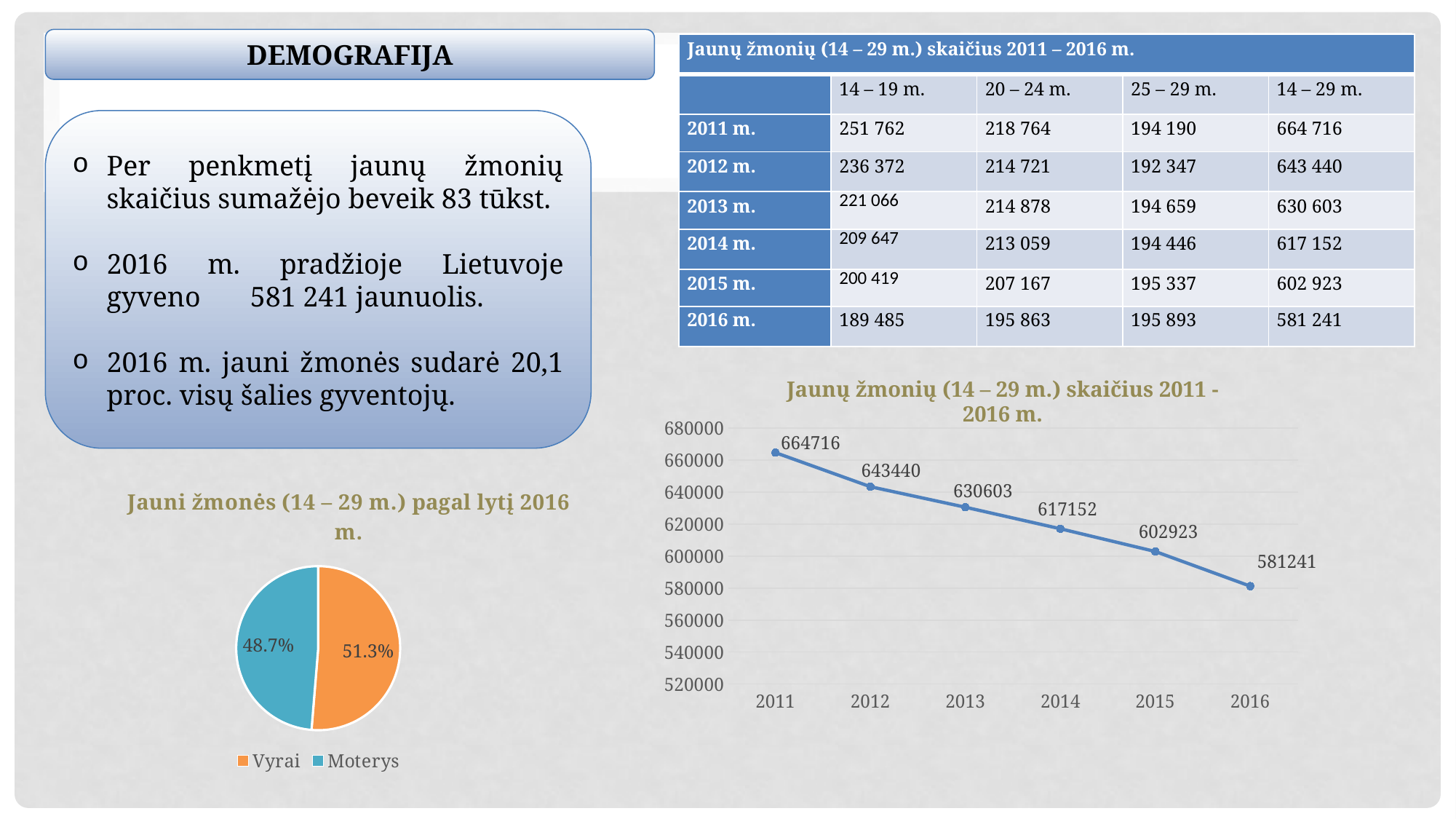
What kind of chart is 'Jaunų žmonių (14 – 29 m.) skaičius 2011 - 2016 m.'? line chart In the line chart 'Jaunų žmonių (14 – 29 m.) skaičius 2011 - 2016 m.', which year has the lowest value? 2016 In the pie chart 'Jauni žmonės (14 – 29 m.) pagal lytį 2016 m.', what share is Vyrai? 51.3% In the line chart 'Jaunų žmonių (14 – 29 m.) skaičius 2011 - 2016 m.', what is the value for 2011? 664716 In the line chart 'Jaunų žmonių (14 – 29 m.) skaičius 2011 - 2016 m.', how many years are plotted? 6 In the line chart 'Jaunų žmonių (14 – 29 m.) skaičius 2011 - 2016 m.', which year has the highest value? 2011 In the pie chart 'Jauni žmonės (14 – 29 m.) pagal lytį 2016 m.', how many entries does the legend list? 2 In the line chart 'Jaunų žmonių (14 – 29 m.) skaičius 2011 - 2016 m.', do the values rise or fall from 2011 to 2016? fall In the line chart 'Jaunų žmonių (14 – 29 m.) skaičius 2011 - 2016 m.', what is the difference between the 2011 and 2016 values? 83475 In the line chart 'Jaunų žmonių (14 – 29 m.) skaičius 2011 - 2016 m.', what is the value for 2016? 581241 In the line chart 'Jaunų žmonių (14 – 29 m.) skaičius 2011 - 2016 m.', what is the value for 2014? 617152 In the pie chart 'Jauni žmonės (14 – 29 m.) pagal lytį 2016 m.', which slice is larger, Vyrai or Moterys? Vyrai